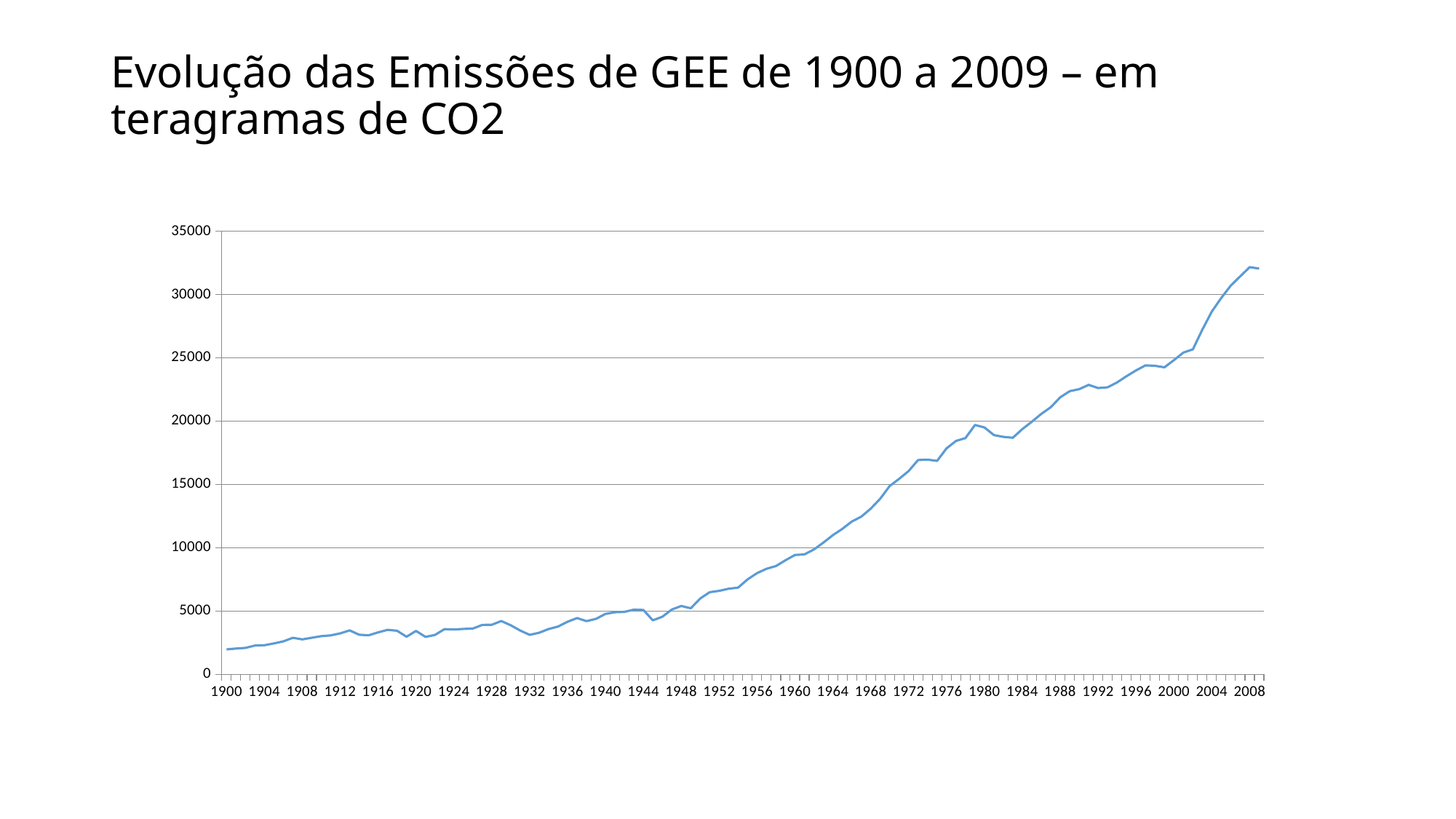
Is the value for 1988 greater or less than 20000? greater Is the value for 2008 greater or less than 30000? greater Which year has the lowest emissions value on the chart? 1900 Is the value for 1932 greater or less than 5000? less What kind of chart is shown on the slide? line chart Overall, do the emission values rise or fall from 1900 to 2009? rise Which year has the larger emissions value, 1940 or 2000? 2000 What is the title of the chart on the slide? Evolução das Emissões de GEE de 1900 a 2009 – em teragramas de CO2 What is the highest value shown on the vertical axis? 35000